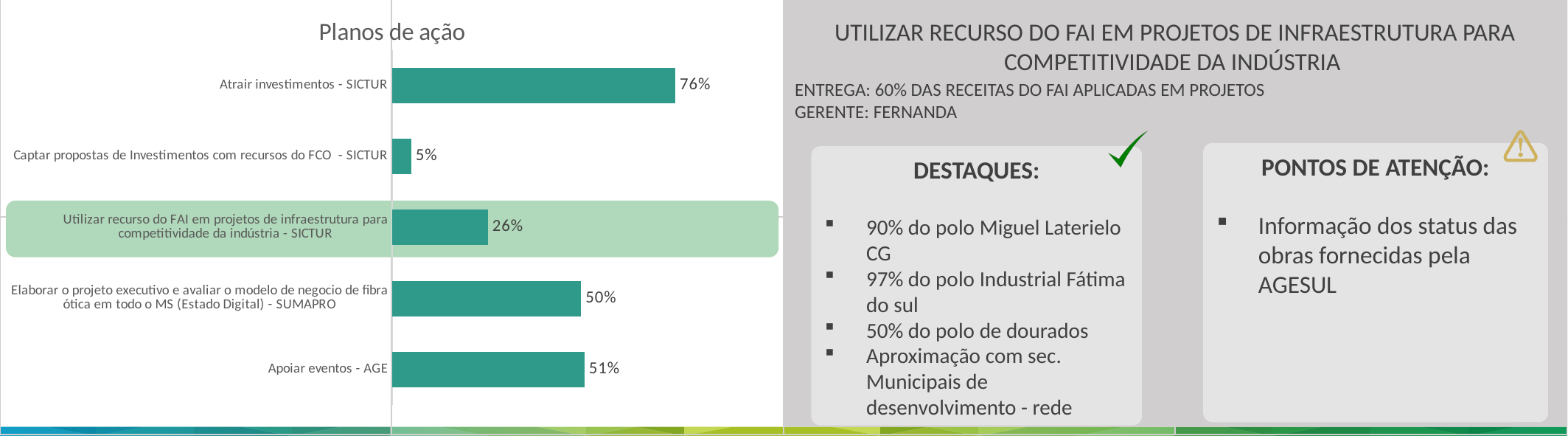
How many action plans are shown in the Planos de ação chart? 5 Which is larger: the value for "Atrair investimentos - SICTUR" or the value for "Utilizar recurso do FAI em projetos de infraestrutura para competitividade da indústria - SICTUR"? Atrair investimentos - SICTUR What is the difference between the values for "Atrair investimentos - SICTUR" and "Apoiar eventos - AGE"? 25% What is the value for "Elaborar o projeto executivo e avaliar o modelo de negocio de fibra ótica em todo o MS (Estado Digital) - SUMAPRO"? 50% What kind of chart is the Planos de ação chart? Bar chart Which action plan has the lowest value in the Planos de ação chart? Captar propostas de Investimentos com recursos do FCO - SICTUR What is the value for "Apoiar eventos - AGE" in the Planos de ação chart? 51% What is the value for "Captar propostas de Investimentos com recursos do FCO - SICTUR"? 5% What is the value for "Utilizar recurso do FAI em projetos de infraestrutura para competitividade da indústria - SICTUR"? 26% What is the value for "Atrair investimentos - SICTUR" in the Planos de ação chart? 76% What is the difference between the values for "Utilizar recurso do FAI em projetos de infraestrutura para competitividade da indústria - SICTUR" and "Captar propostas de Investimentos com recursos do FCO - SICTUR"? 21% Which action plan has the highest value in the Planos de ação chart? Atrair investimentos - SICTUR